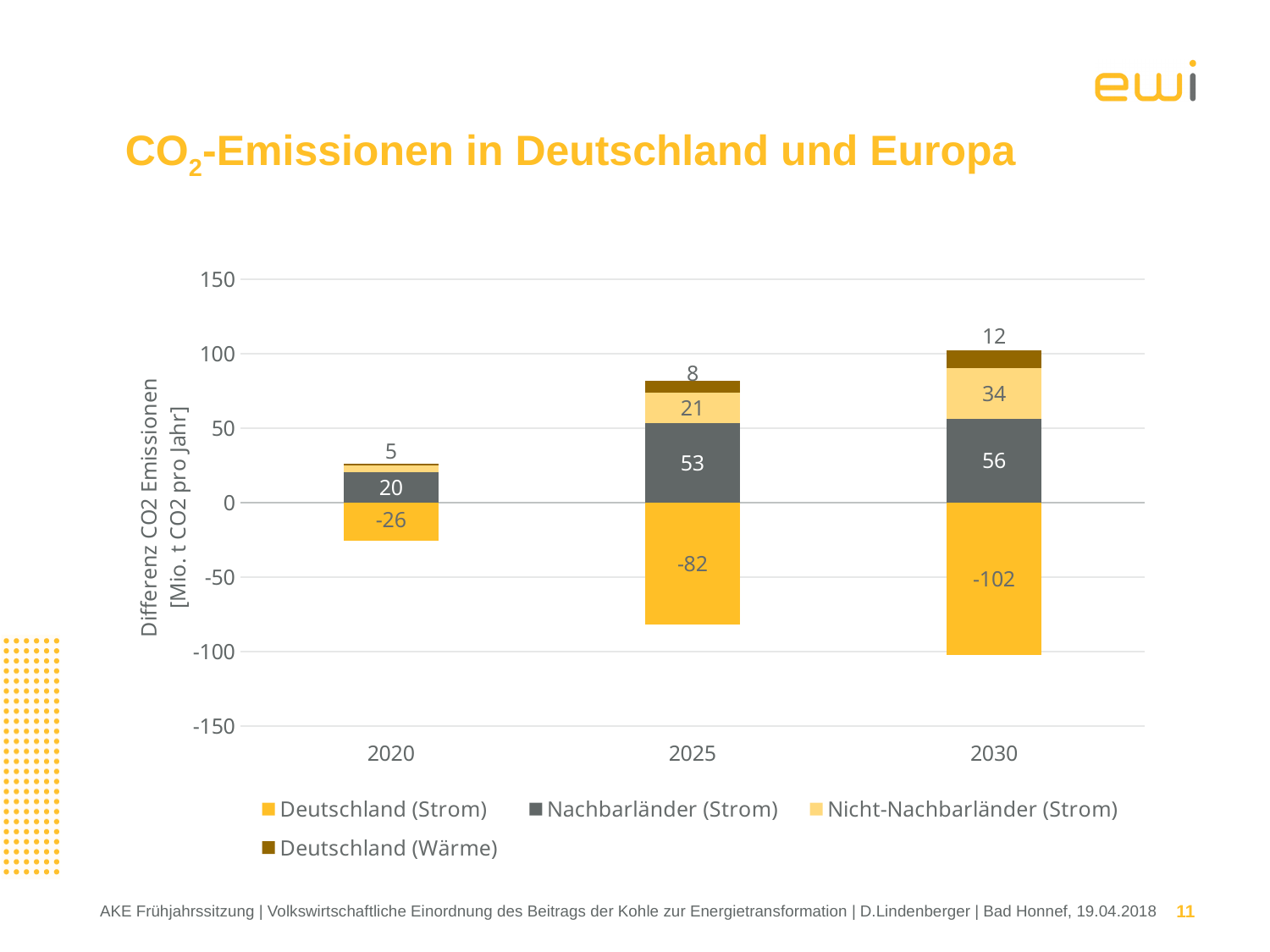
What is the value for Deutschland (Strom) in 2030? -102 Do the values for Nachbarländer (Strom) rise or fall from 2020 to 2030? Rise What is the value for Nachbarländer (Strom) in 2025? 53 What is the value for Nicht-Nachbarländer (Strom) in 2030? 34 What is the difference between the Nicht-Nachbarländer (Strom) values for 2030 and 2025? 13 How many series does the legend list? 4 What is the value for Deutschland (Wärme) in 2025? 8 What kind of chart is shown on the slide? Stacked bar chart In which year is the value for Nachbarländer (Strom) highest? 2030 Which is larger in 2025: Nachbarländer (Strom) or Nicht-Nachbarländer (Strom)? Nachbarländer (Strom) How many years are shown on the x axis? 3 In which year is the value for Deutschland (Strom) lowest? 2030